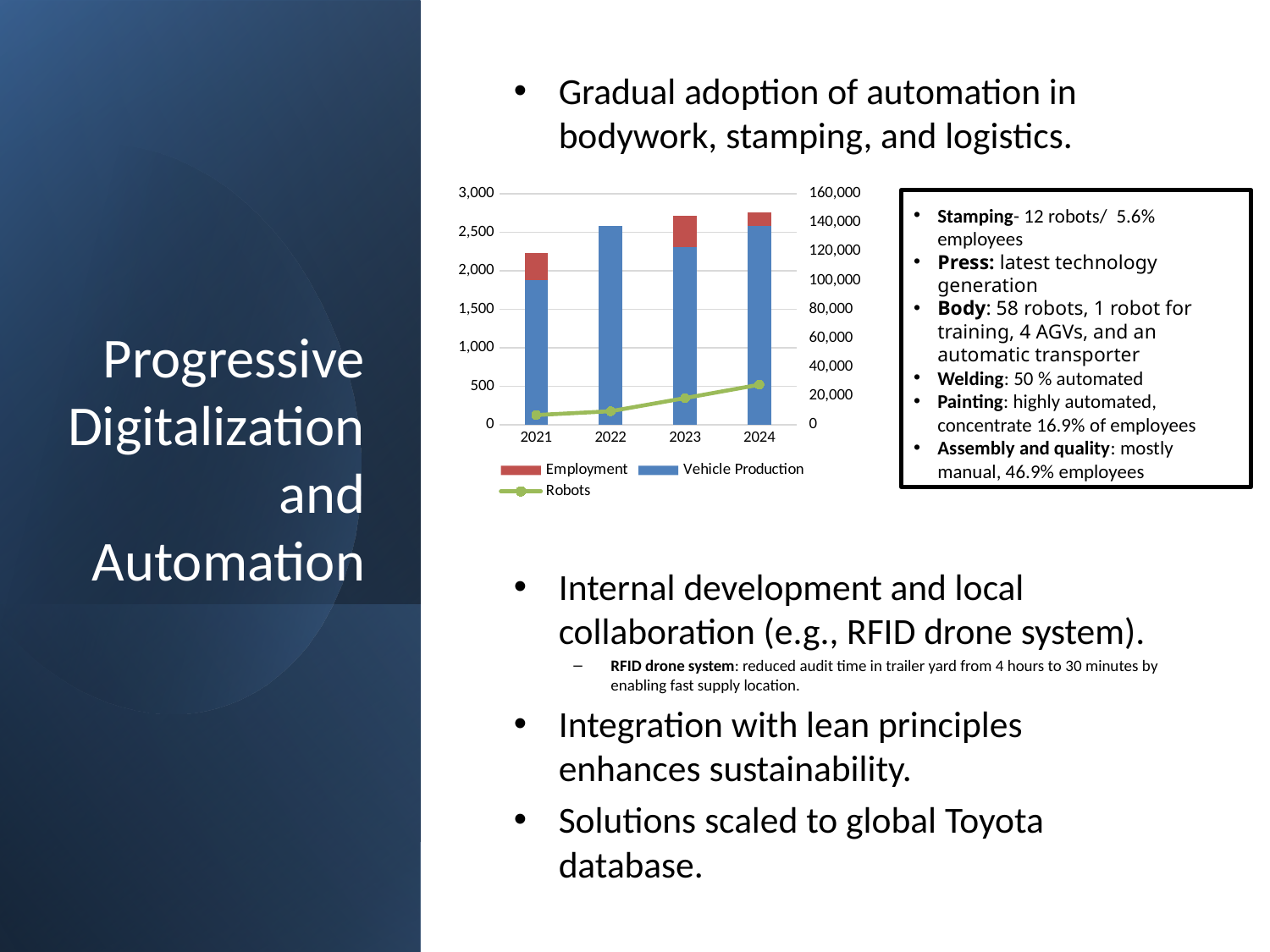
Does the Robots line rise or fall from 2021 to 2024? Rises What kind of chart is shown on the slide? A combined bar and line chart In which year is the Robots value lowest? 2021 How many series does the chart legend list? 3 How many years are shown on the x axis of the chart? 4 In which year is the Robots value highest? 2024 What is the highest tick value on the left vertical axis of the chart? 3,000 Which year has the shortest stacked bar in the chart? 2021 What is the first year shown on the x axis of the chart? 2021 Which series are listed in the chart legend? Employment, Vehicle Production, Robots Which series is drawn as a line in the chart? Robots Is the Robots value larger in 2024 or in 2021? 2024